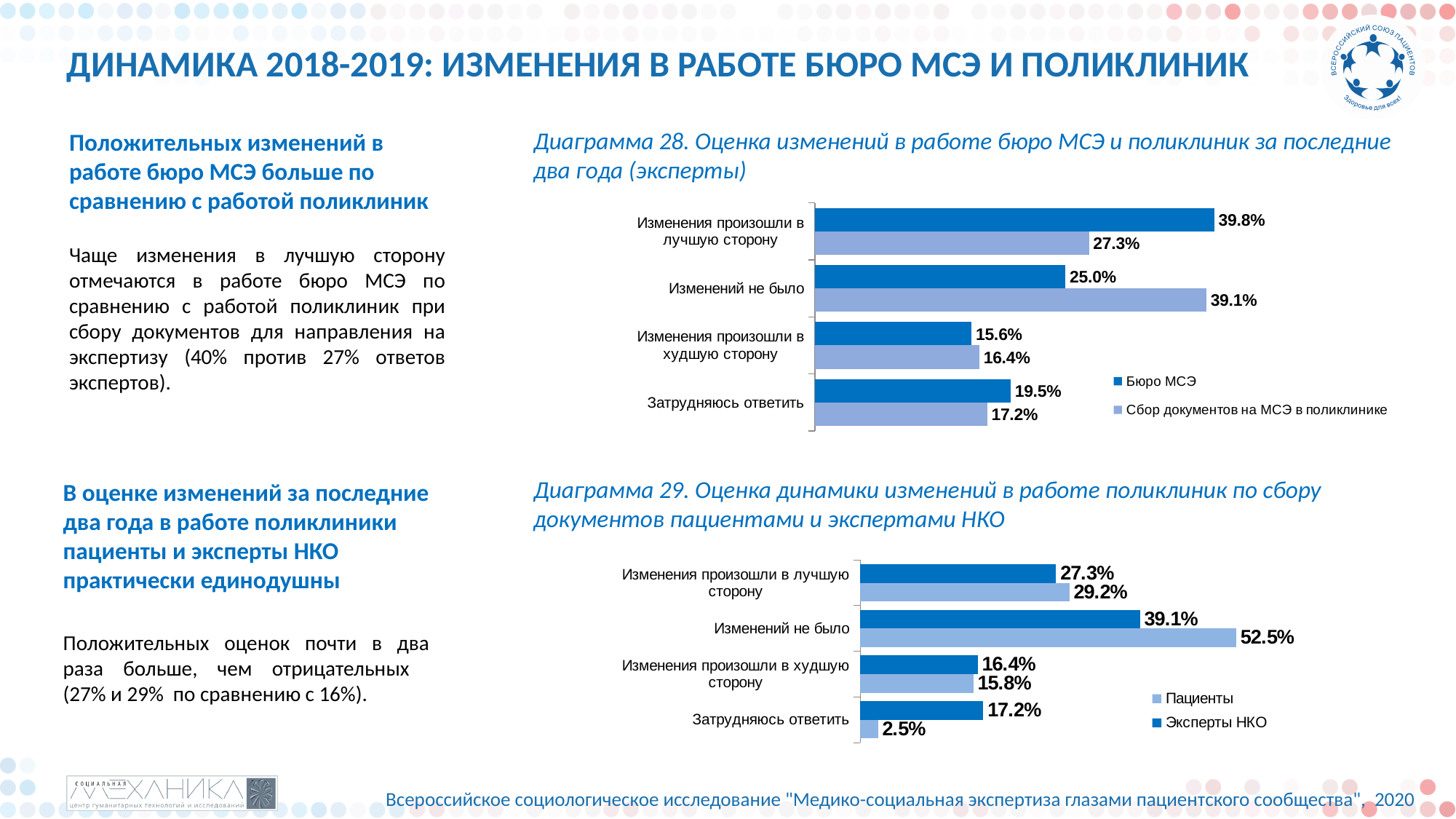
In Диаграмма 29, what is the difference between Пациенты and Эксперты НКО for 'Изменений не было'? 13.4% In Диаграмма 29, what is the value for Пациенты in the category 'Изменений не было'? 52.5% In Диаграмма 28, what is the value for 'Сбор документов на МСЭ в поликлинике' in the category 'Изменений не было'? 39.1% What type of chart is Диаграмма 28? Bar chart In Диаграмма 28, which category has the highest value for Бюро МСЭ? Изменения произошли в лучшую сторону In Диаграмма 29, what is the value for Эксперты НКО in the category 'Затрудняюсь ответить'? 17.2% In Диаграмма 28, what is the value for Бюро МСЭ in the category 'Изменения произошли в лучшую сторону'? 39.8% In Диаграмма 28, how many series does the legend list? 2 In Диаграмма 28, what is the difference between the Бюро МСЭ and 'Сбор документов на МСЭ в поликлинике' values for 'Изменения произошли в лучшую сторону'? 12.5% How many categories are shown in Диаграмма 29? 4 In Диаграмма 29, which category has the lowest value for Пациенты? Затрудняюсь ответить In Диаграмма 29, which is larger for 'Изменения произошли в лучшую сторону': Пациенты or Эксперты НКО? Пациенты